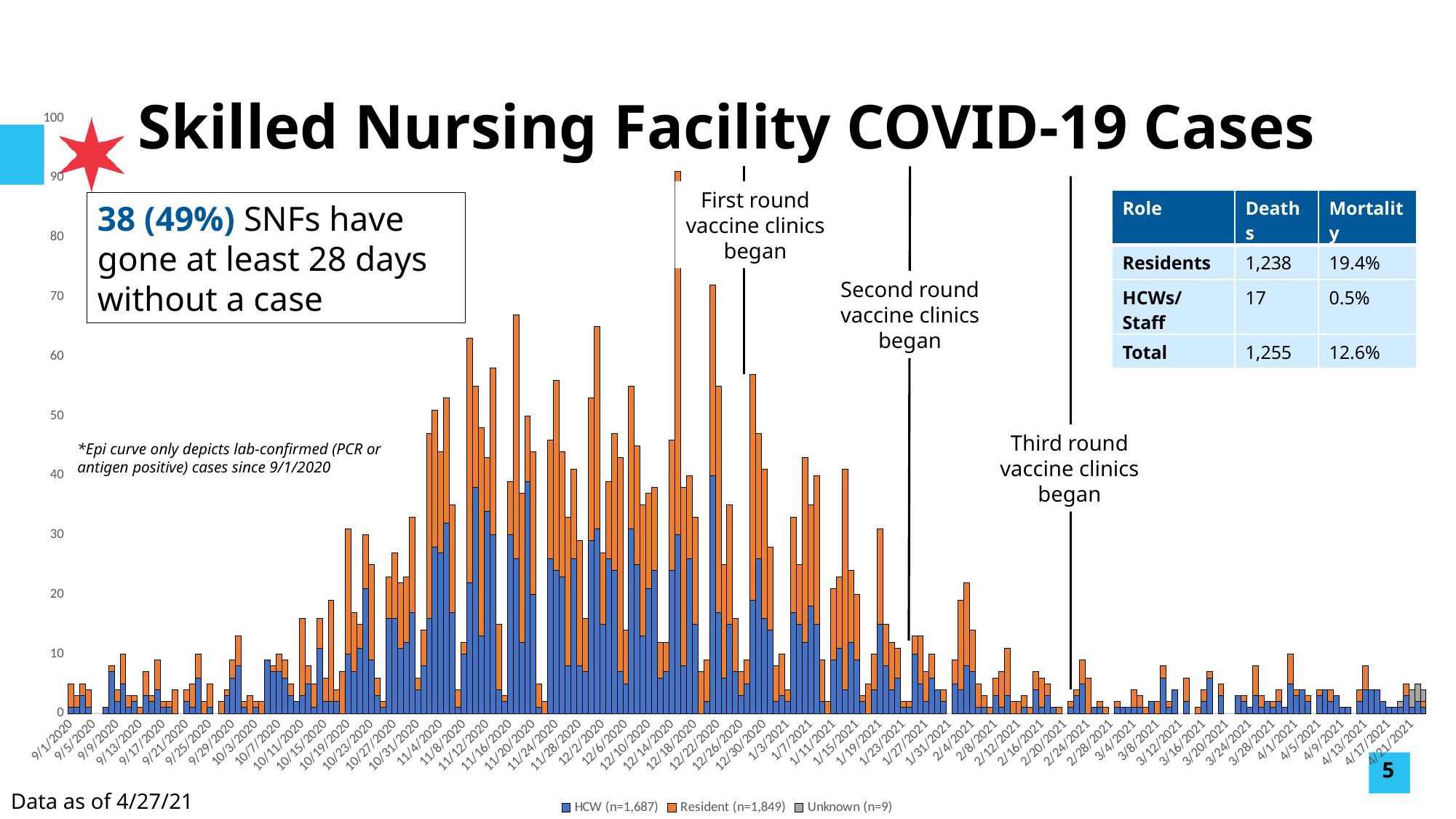
How many series does the chart legend list? 3 What kind of chart is shown on the slide? Stacked bar chart Are the bars in mid-December 2020 taller or shorter than the bars in mid-March 2021? taller Is the value for 9/1/2020 greater or less than 10? less In which month does the tallest bar of the chart occur? December 2020 Do the daily case counts generally rise or fall from early September 2020 to mid-November 2020? rise Is the tallest bar in the chart greater or less than 80? greater What are the three series named in the chart legend? HCW, Resident, Unknown Do the daily case counts generally rise or fall from mid-January 2021 to early March 2021? fall According to the legend, how many Resident cases (n) are in the chart? 1,849